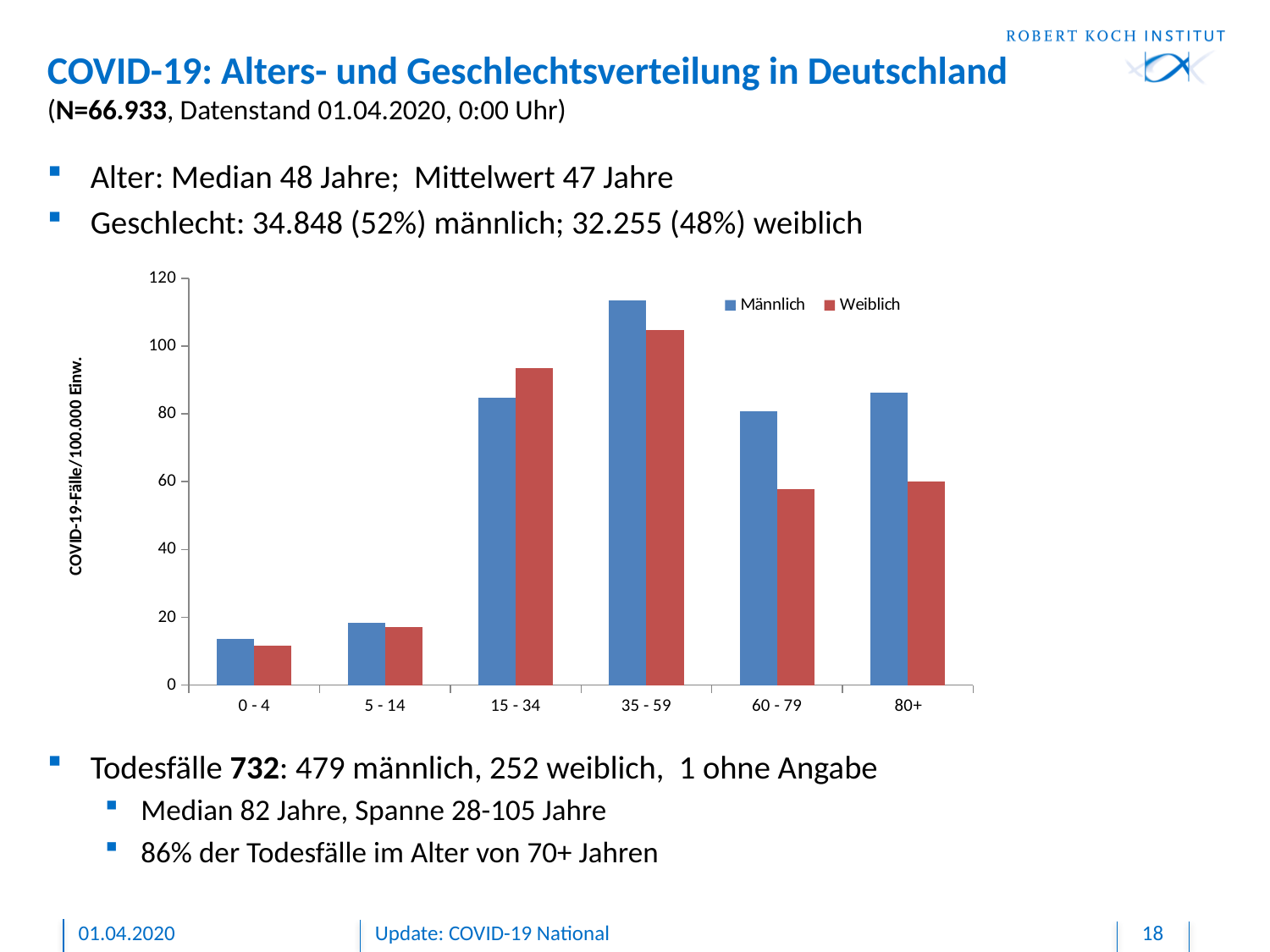
How many age groups are shown on the x axis of the chart? 6 What kind of chart is shown on the slide? bar chart Which age group has the lowest value for Weiblich? 0 - 4 How many series does the chart legend list? 2 Is the value for Männlich in the 35 - 59 age group greater or less than 100? greater Is the value for Weiblich in the 60 - 79 age group greater or less than 80? less Which age group has the highest value for Weiblich? 35 - 59 In the 60 - 79 age group, which is larger: Männlich or Weiblich? Männlich Is the value for Männlich in the 80+ age group greater or less than 80? greater In the 15 - 34 age group, which is larger: Männlich or Weiblich? Weiblich Which age group has the highest value for Männlich? 35 - 59 What is the label of the y axis of the chart? COVID-19-Fälle/100.000 Einw.